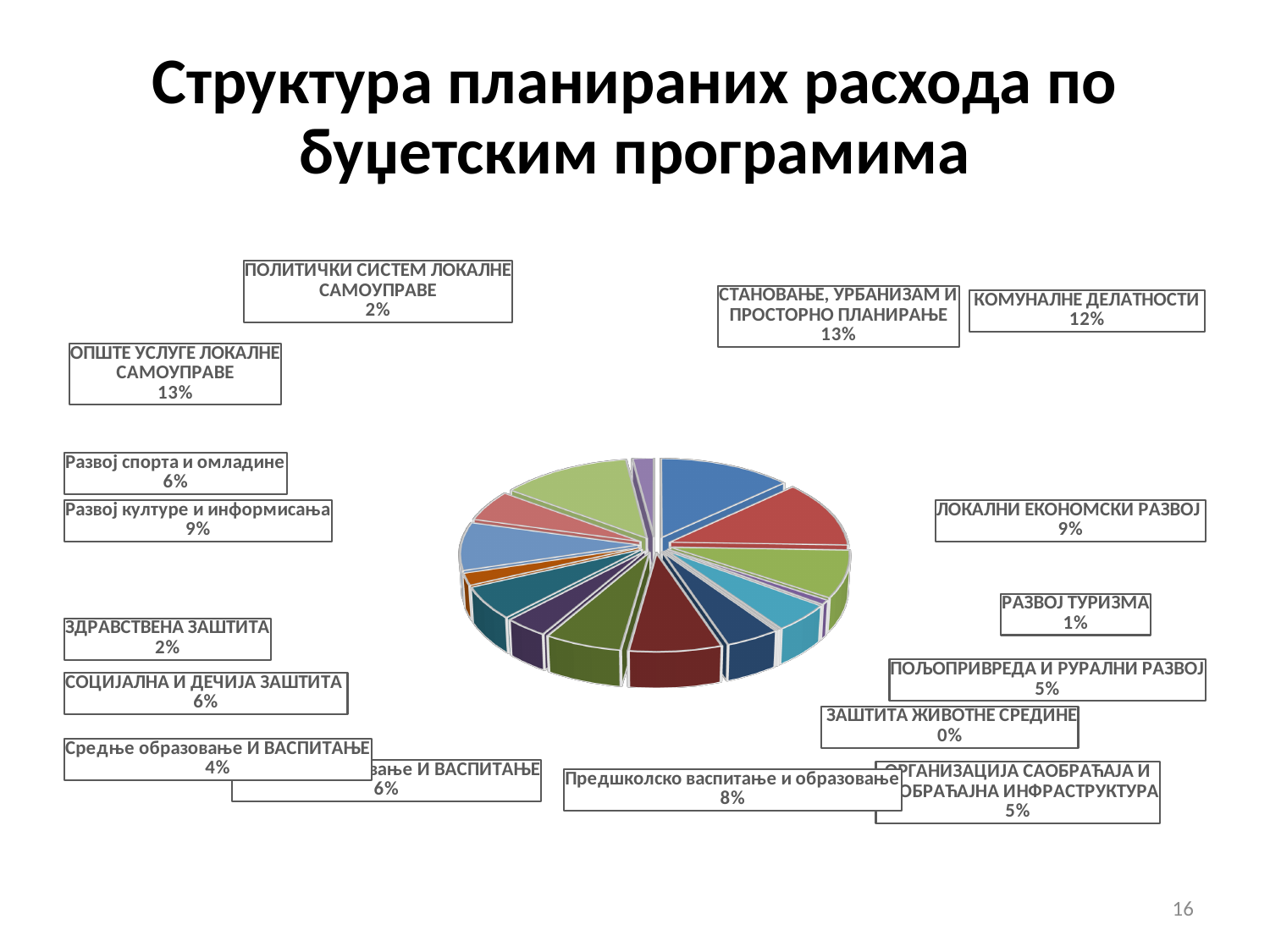
Which has a larger share: СОЦИЈАЛНА И ДЕЧИЈА ЗАШТИТА or ЗДРАВСТВЕНА ЗАШТИТА? СОЦИЈАЛНА И ДЕЧИЈА ЗАШТИТА What percentage is shown for СТАНОВАЊЕ, УРБАНИЗАМ И ПРОСТОРНО ПЛАНИРАЊЕ? 13% Which program has the smallest share in the pie chart? ЗАШТИТА ЖИВОТНЕ СРЕДИНЕ What share of planned expenditure goes to КОМУНАЛНЕ ДЕЛАТНОСТИ? 12% What is the title of the chart on the slide? Структура планираних расхода по буџетским програмима What percentage is shown for ОПШТЕ УСЛУГЕ ЛОКАЛНЕ САМОУПРАВЕ? 13% What kind of chart is shown on the slide? Pie chart What is the difference in percentage points between СТАНОВАЊЕ, УРБАНИЗАМ И ПРОСТОРНО ПЛАНИРАЊЕ and КОМУНАЛНЕ ДЕЛАТНОСТИ? 1% What percentage is shown for Предшколско васпитање и образовање? 8% What is the difference between the shares of Развој културе и информисања and Развој спорта и омладине? 3% What share is labelled for РАЗВОЈ ТУРИЗМА? 1% Which has a larger share: КОМУНАЛНЕ ДЕЛАТНОСТИ or ЛОКАЛНИ ЕКОНОМСКИ РАЗВОЈ? КОМУНАЛНЕ ДЕЛАТНОСТИ